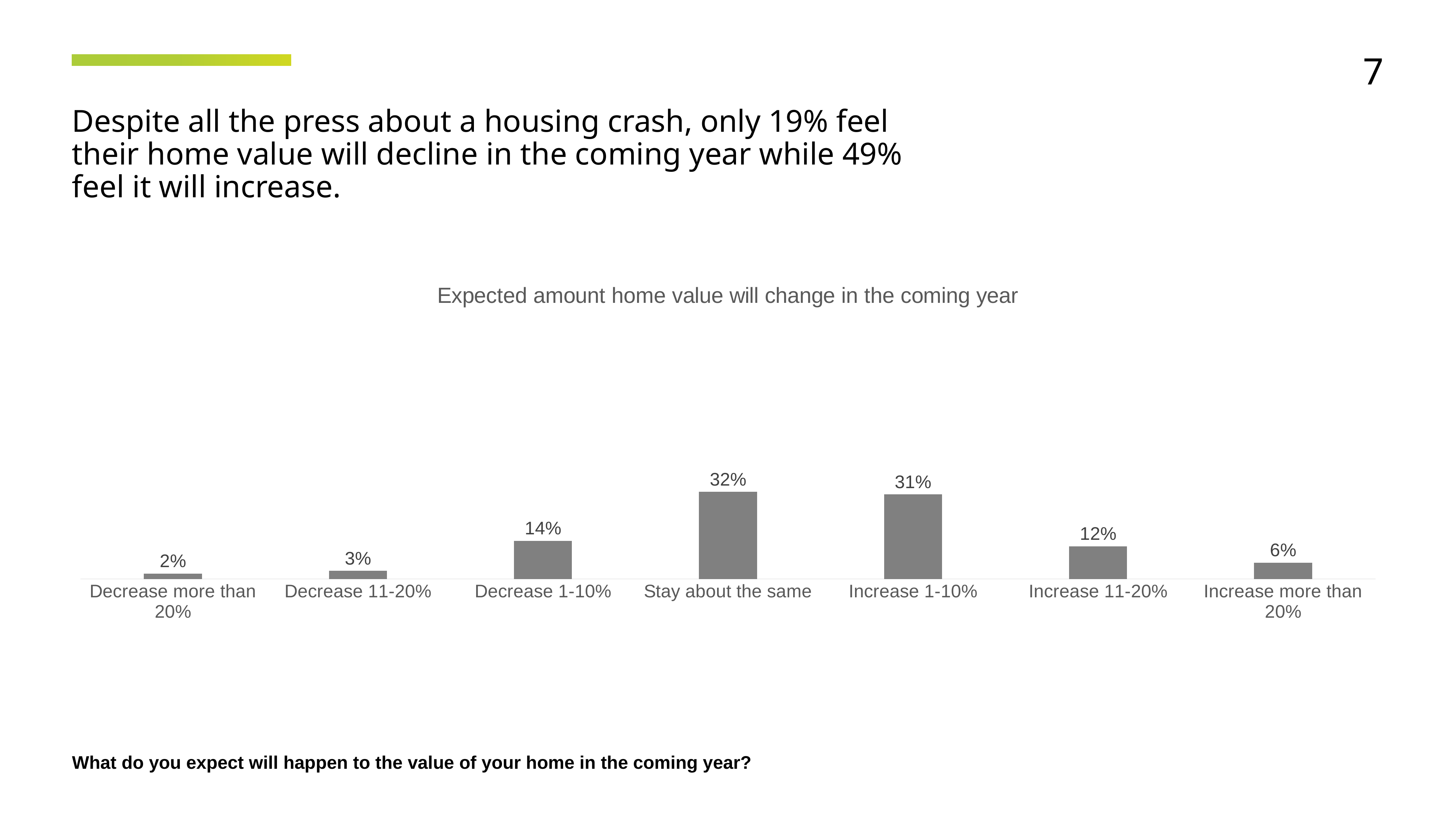
What is the title of the chart? Expected amount home value will change in the coming year Which category has the lowest value? Decrease more than 20% What is the difference between the values for "Increase 1-10%" and "Increase 11-20%"? 19% What is the value for "Stay about the same"? 32% How many categories are shown in the chart? 7 What kind of chart is shown on the slide? Bar chart What is the value for "Increase more than 20%"? 6% Which category has the highest value? Stay about the same What is the difference between the values for "Decrease 11-20%" and "Decrease more than 20%"? 1% What is the value for "Decrease 11-20%"? 3% Which is larger, the value for "Decrease 1-10%" or the value for "Increase 11-20%"? Decrease 1-10% What is the value for "Decrease 1-10%"? 14%